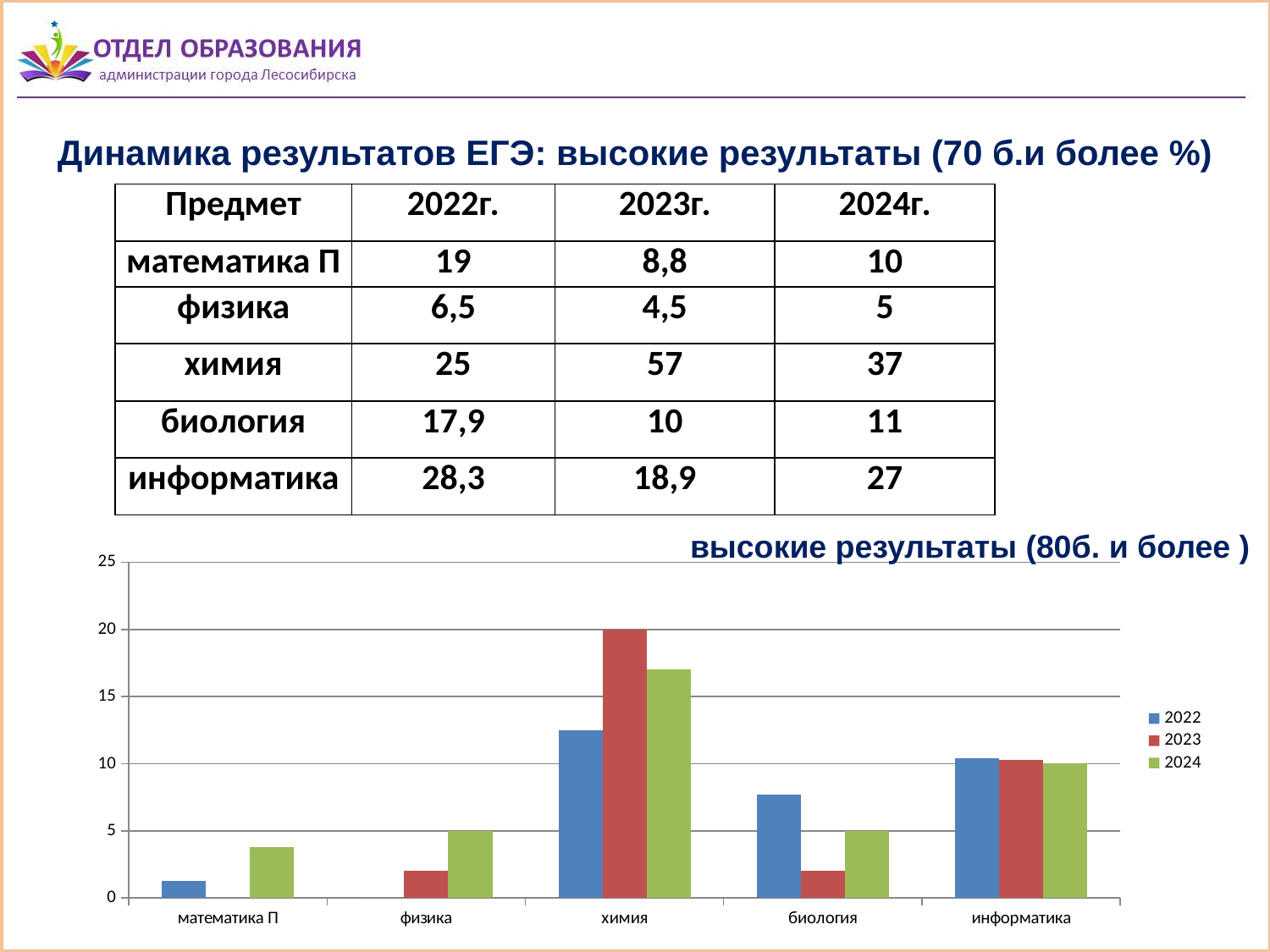
What kind of chart is shown on the slide? bar chart In the chart, which is larger for биология: the 2022 value or the 2024 value? 2022 Which subject has the tallest bar in the chart? химия What is the title of the chart? высокие результаты (80б. и более ) In the chart, is the 2022 value for биология greater or less than 10? less How many subject categories are shown on the x axis of the chart? 5 How many series does the chart legend list? 3 Which series are listed in the chart legend? 2022, 2023, 2024 In the chart, which is larger for химия: the 2023 value or the 2024 value? 2023 In the chart, is the 2023 value for химия greater or less than 15? greater In the chart, is the 2022 value for химия greater or less than 10? greater